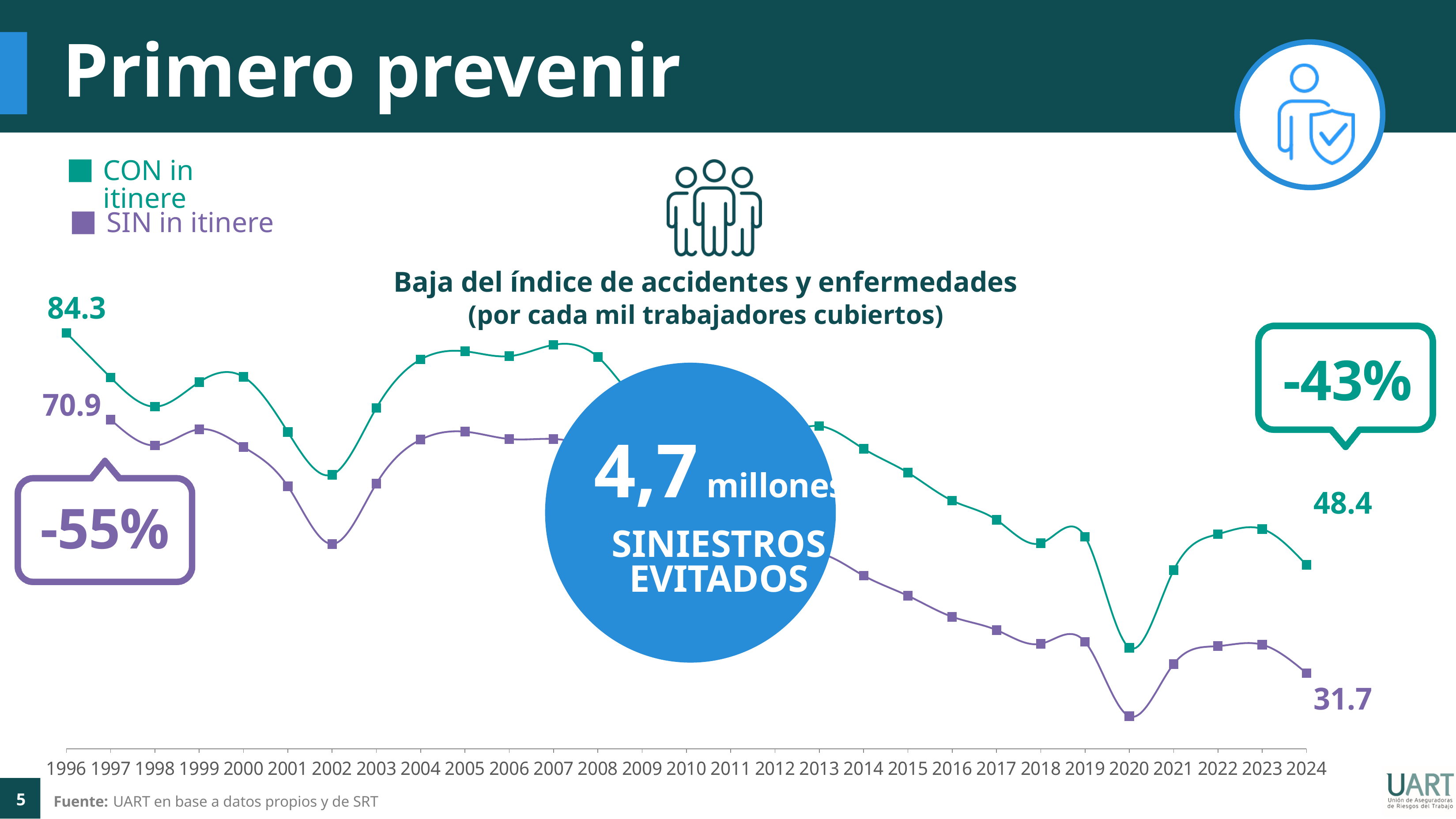
What is the value for CON in itinere in 1996? 84.3 What is the difference between the CON in itinere values for 1996 and 2024? 35.9 In which year is the SIN in itinere series at its highest? 1997 How many series does the legend list? 2 What is the value for CON in itinere in 2024? 48.4 In which year is the CON in itinere series at its lowest? 2020 Do the values of the SIN in itinere series generally rise or fall from 1996 to 2024? Fall Which series has the higher value in 2024, CON in itinere or SIN in itinere? CON in itinere What kind of chart is shown on the slide? Line chart What is the value for SIN in itinere in 2024? 31.7